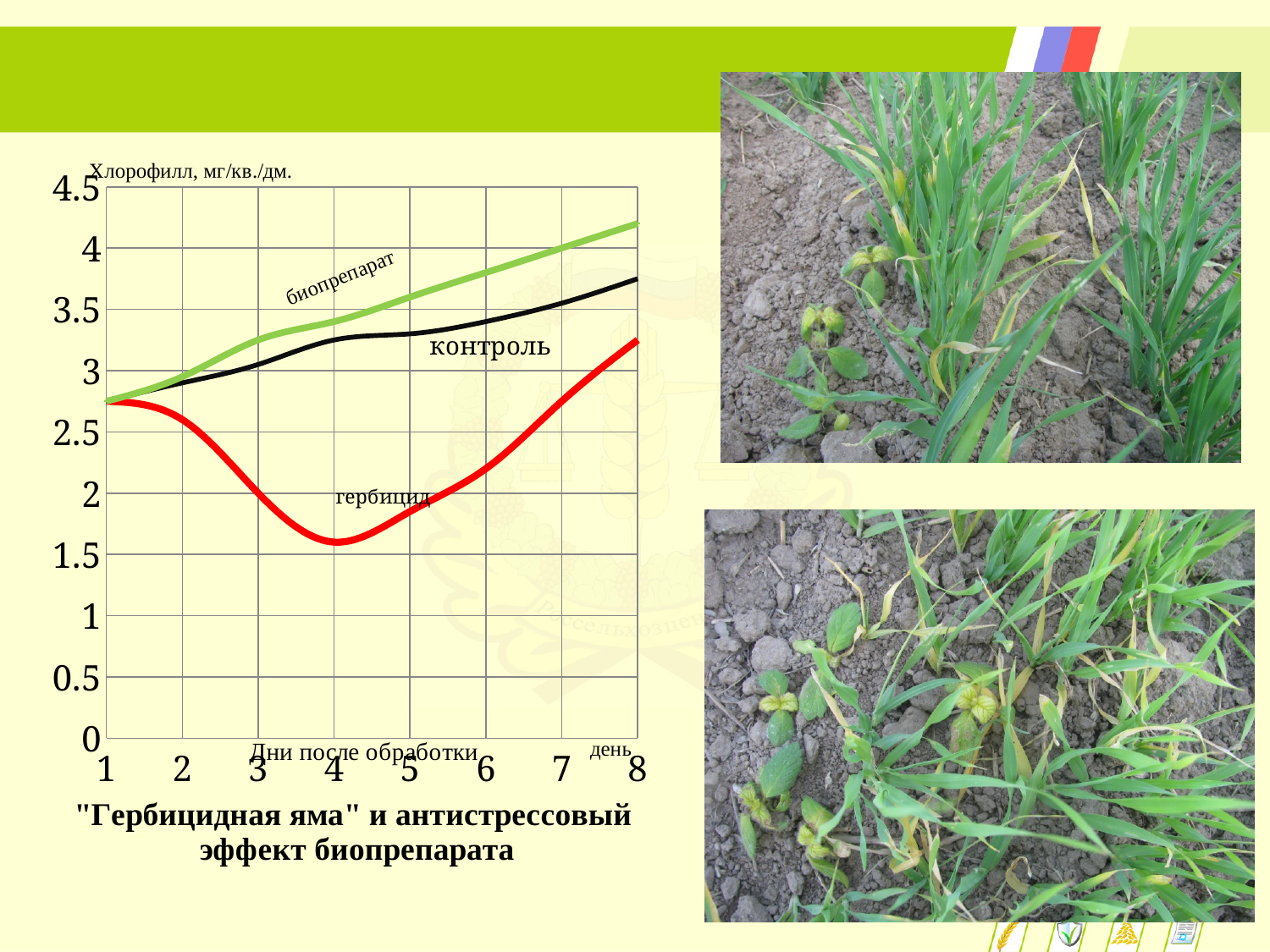
On day 8, which is larger: the value for "биопрепарат" or the value for "контроль"? биопрепарат Is the value for "гербицид" on day 4 greater or less than 2? less Is the value for "биопрепарат" on day 8 greater or less than 4? greater What is the label of the y axis of the chart? Хлорофилл, мг/кв./дм. Which series has the lowest value on day 4? гербицид Does the "контроль" line rise or fall from day 1 to day 8? rise What kind of chart is shown on the slide? line chart How many series are plotted on the chart? 3 Is the value for "гербицид" on day 8 greater or less than 3? greater Which series has the highest value on day 8? биопрепарат What colour is the line labelled "гербицид"? red